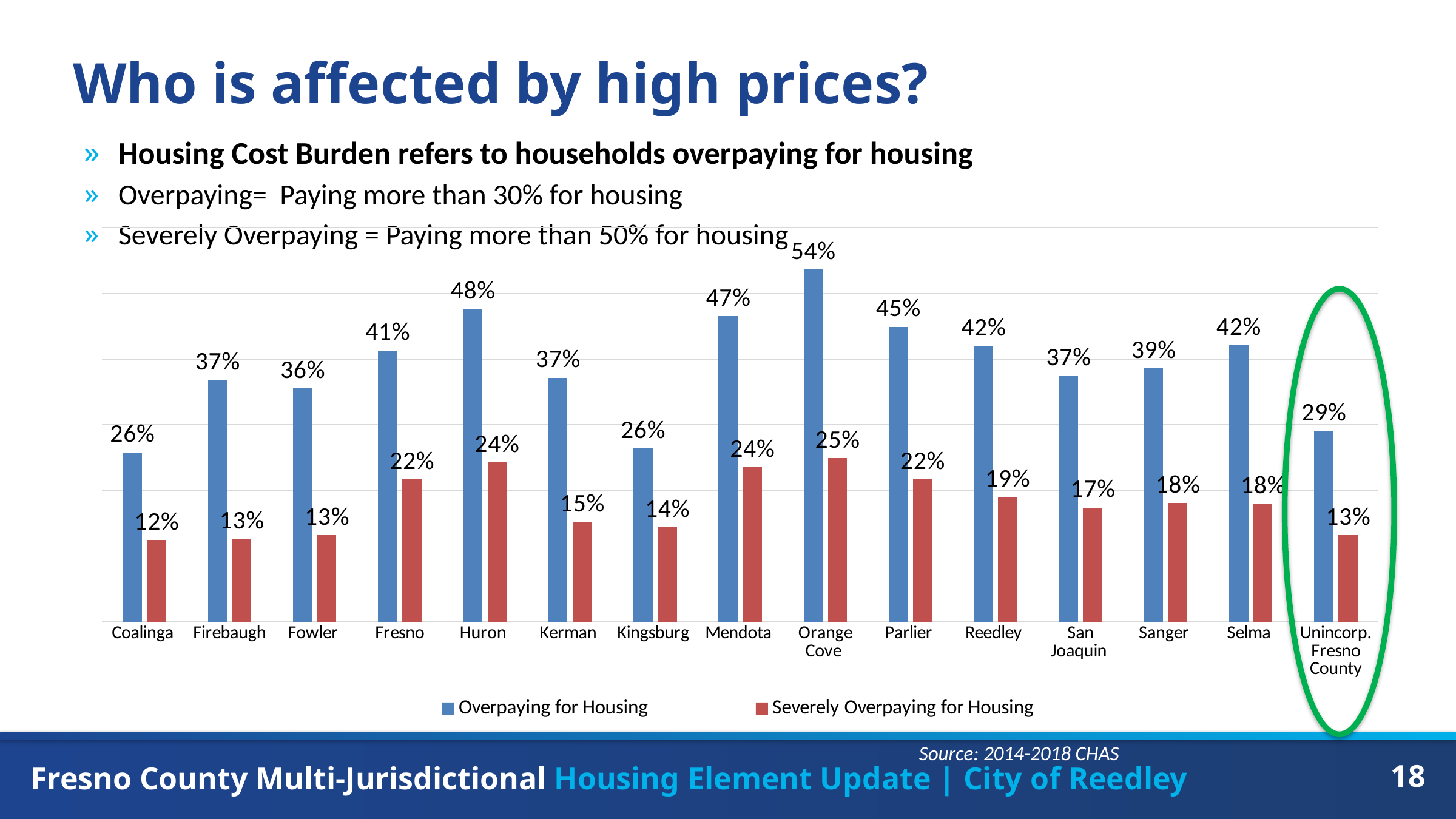
How many categories are shown on the x axis of the chart? 15 What is the difference between the Overpaying for Housing and Severely Overpaying for Housing values for Mendota? 23% Which is larger, the Overpaying for Housing value for Huron or for Parlier? Huron How many series does the legend list? 2 What kind of chart is shown on the slide? Bar chart What is the Overpaying for Housing value for Reedley? 42% Which legend entry is shown in red? Severely Overpaying for Housing What is the Overpaying for Housing value for Unincorp. Fresno County? 29% What is the Severely Overpaying for Housing value for Huron? 24% What is the difference between the Severely Overpaying for Housing values for Orange Cove and Coalinga? 13% Which category has the highest Overpaying for Housing value? Orange Cove Which category has the lowest Severely Overpaying for Housing value? Coalinga